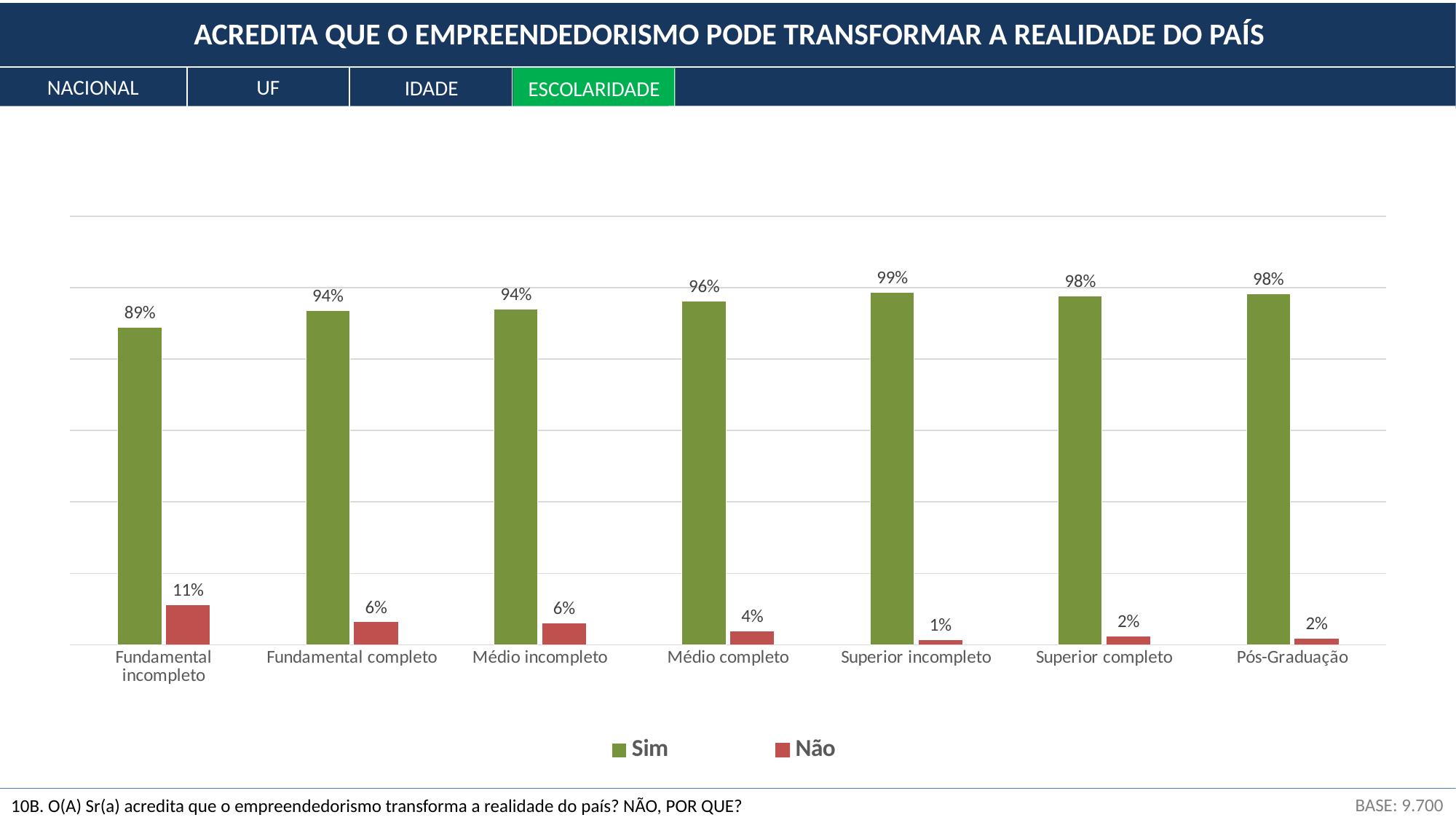
Which category has the highest 'Sim' value? Superior incompleto What is the 'Sim' value for Pós-Graduação? 98% What is the difference between the 'Sim' values for Superior incompleto and Fundamental incompleto? 10% How many series does the legend list? 2 Which category has the highest 'Não' value? Fundamental incompleto How many education categories are shown on the x axis? 7 Which is larger, the 'Não' value for Fundamental completo or for Superior completo? Fundamental completo Which category has the lowest 'Sim' value? Fundamental incompleto What kind of chart is shown on the slide? Bar chart Which colour represents the 'Não' series? Red What is the 'Não' value for Médio completo? 4% What is the 'Sim' value for Fundamental incompleto? 89%